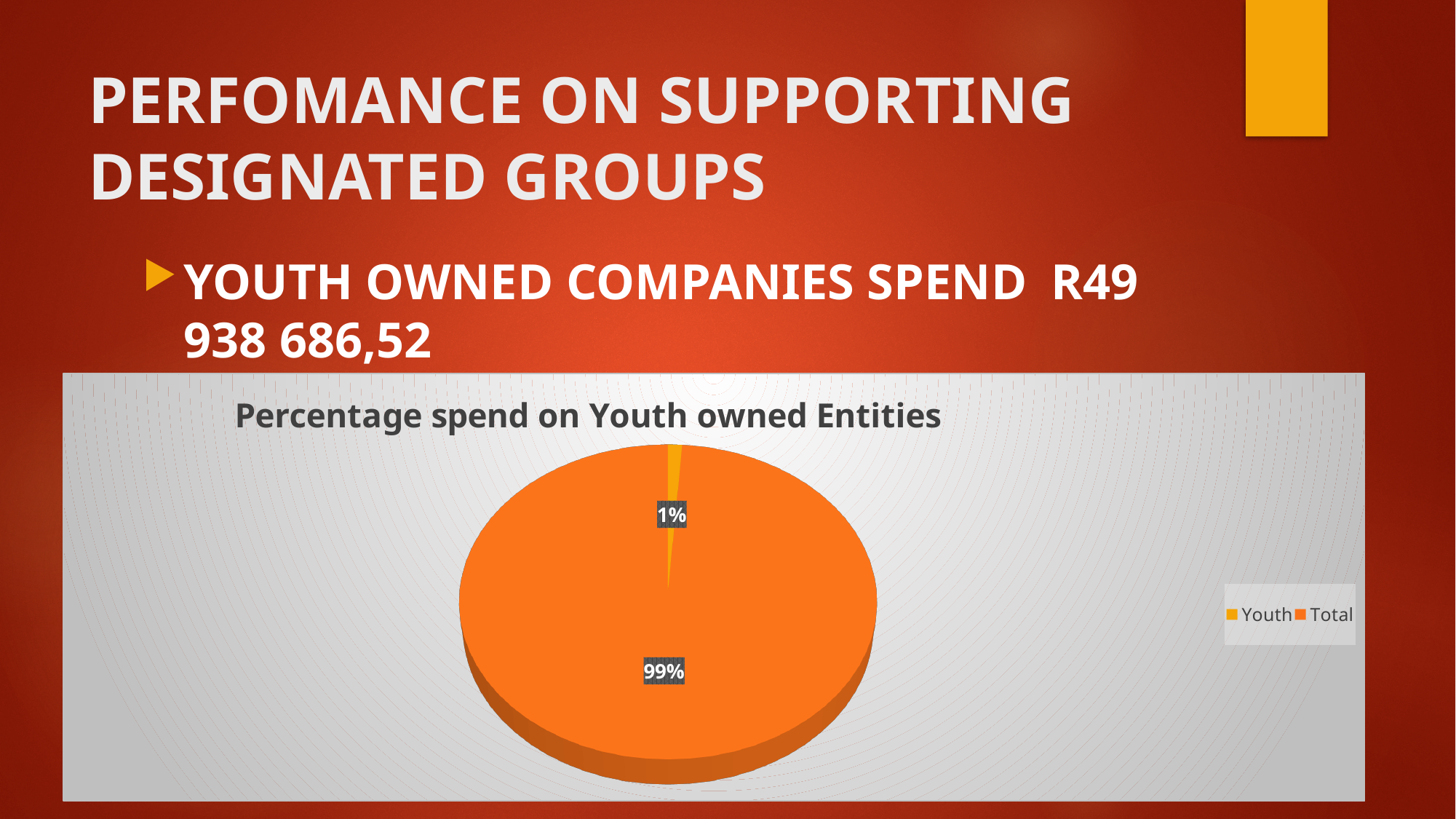
What is the title of the chart? Percentage spend on Youth owned Entities What percentage is shown for the Youth slice? 1% Which is larger, the Youth slice or the Total slice? Total What are the two entries listed in the legend? Youth and Total What is the difference in percentage points between the Total slice and the Youth slice? 98 Which slice is the largest in the pie chart? Total What kind of chart is shown on the slide? pie chart How many entries does the legend list? 2 How many slices does the pie chart have? 2 What share of the pie does the Youth slice represent? 1% What percentage is shown for the Total slice? 99% Which slice is the smallest in the pie chart? Youth